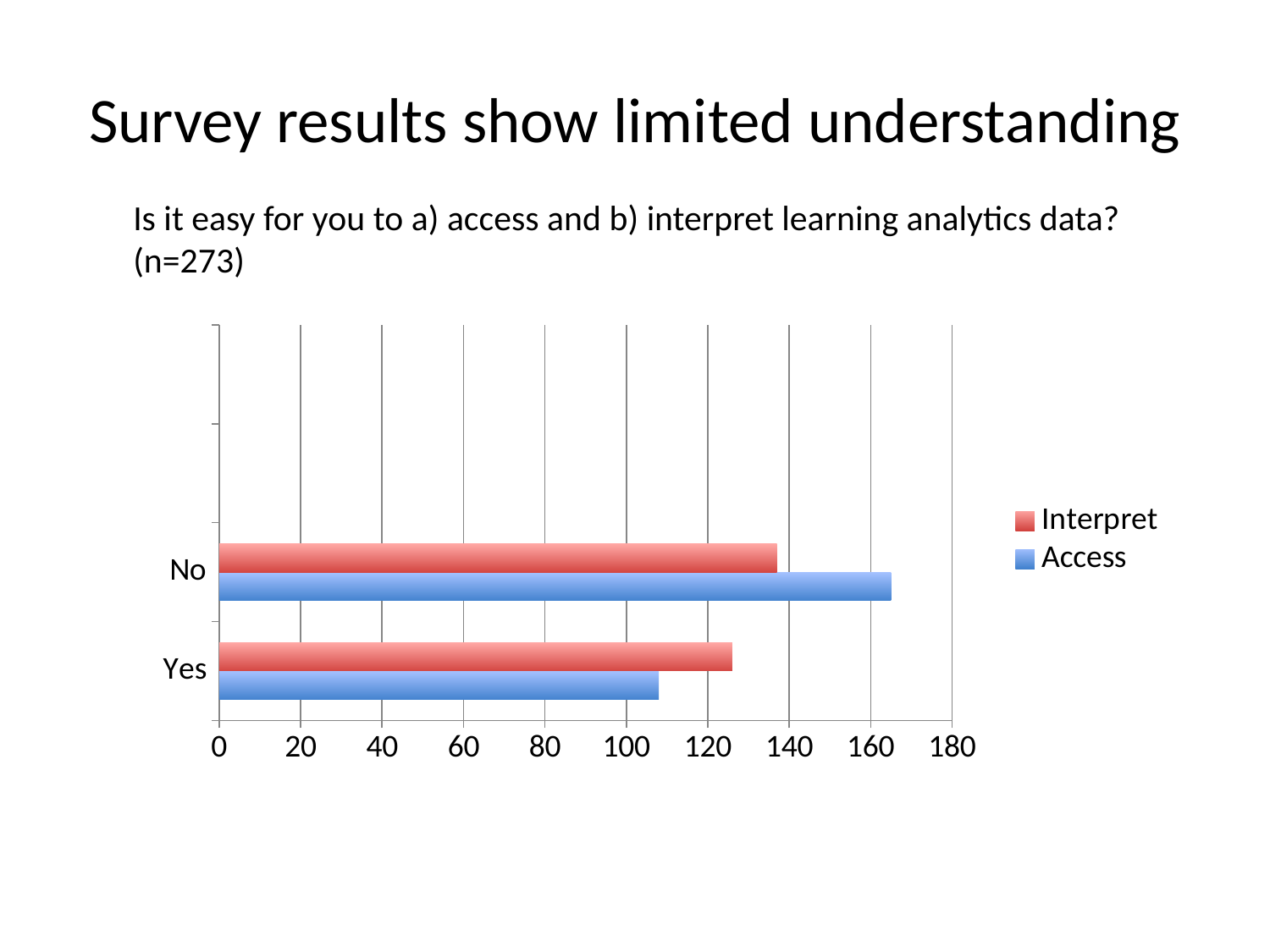
Which category has the lowest Access value? Yes How many series does the legend list? 2 Is the Access value for "Yes" greater or less than 120? less Which colour represents the Interpret series in the legend? red How many categories are shown on the vertical axis of the chart? 2 Which series has the longer bar for the "No" category, Access or Interpret? Access Is the Interpret value for "Yes" greater or less than 120? greater Is the Access value for "No" greater or less than 160? greater What kind of chart is shown on the slide? bar chart Which series has the longer bar for the "Yes" category, Access or Interpret? Interpret Which category has the highest Access value? No